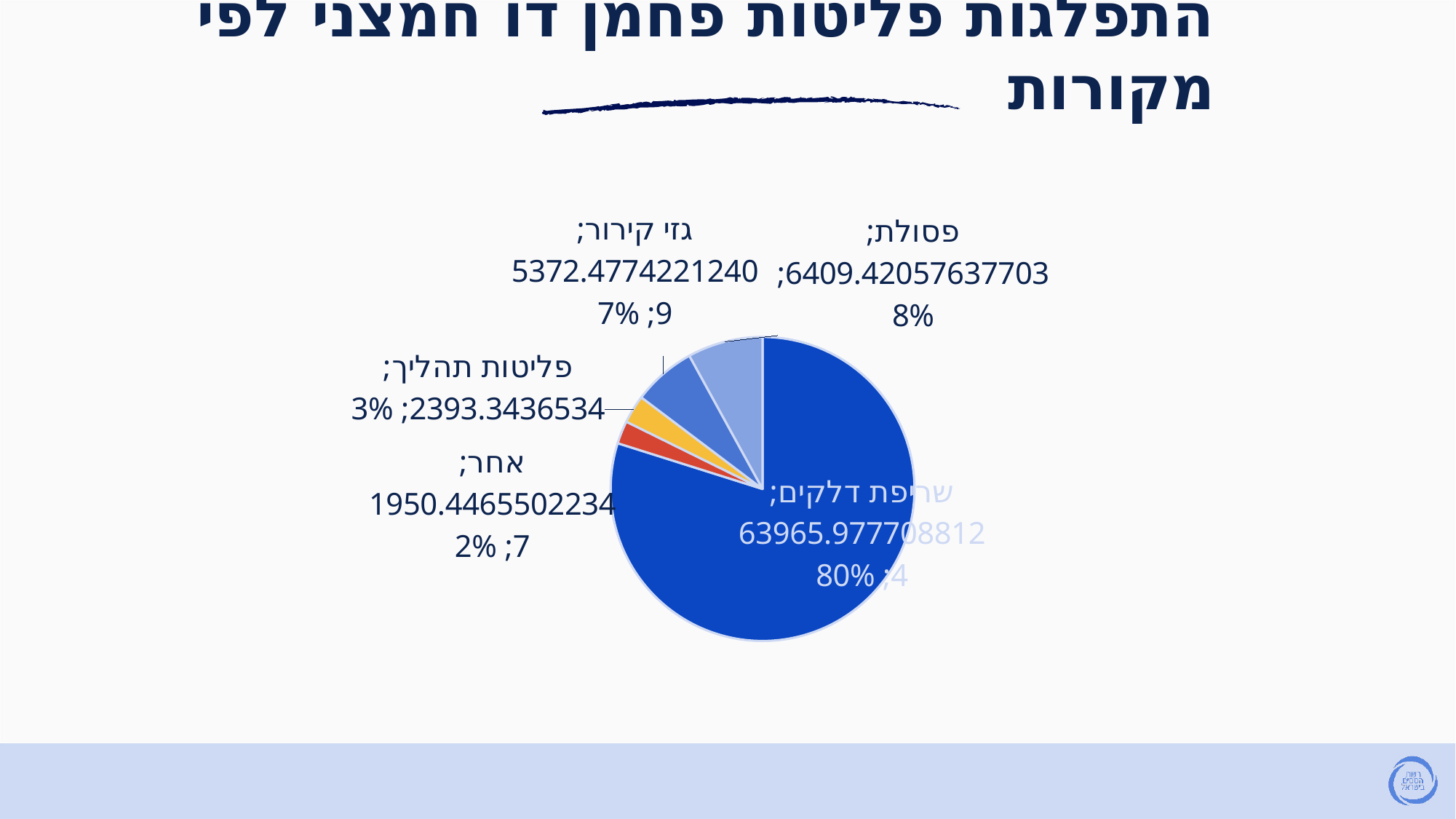
What percentage share does the slice גזי קירור have? 7% Which slice of the pie chart is the smallest? אחר What value is labelled for the slice פליטות תהליך? 2393.3436534 What kind of chart is shown on the slide? pie chart What percentage share does the slice שריפת דלקים have? 80% What percentage share does the slice פסולת have? 8% Which slice is larger, פסולת or גזי קירור? פסולת Which slice of the pie chart is the largest? שריפת דלקים What value is labelled for the slice פסולת? 6409.42057637703 How many slices does the pie chart have? 5